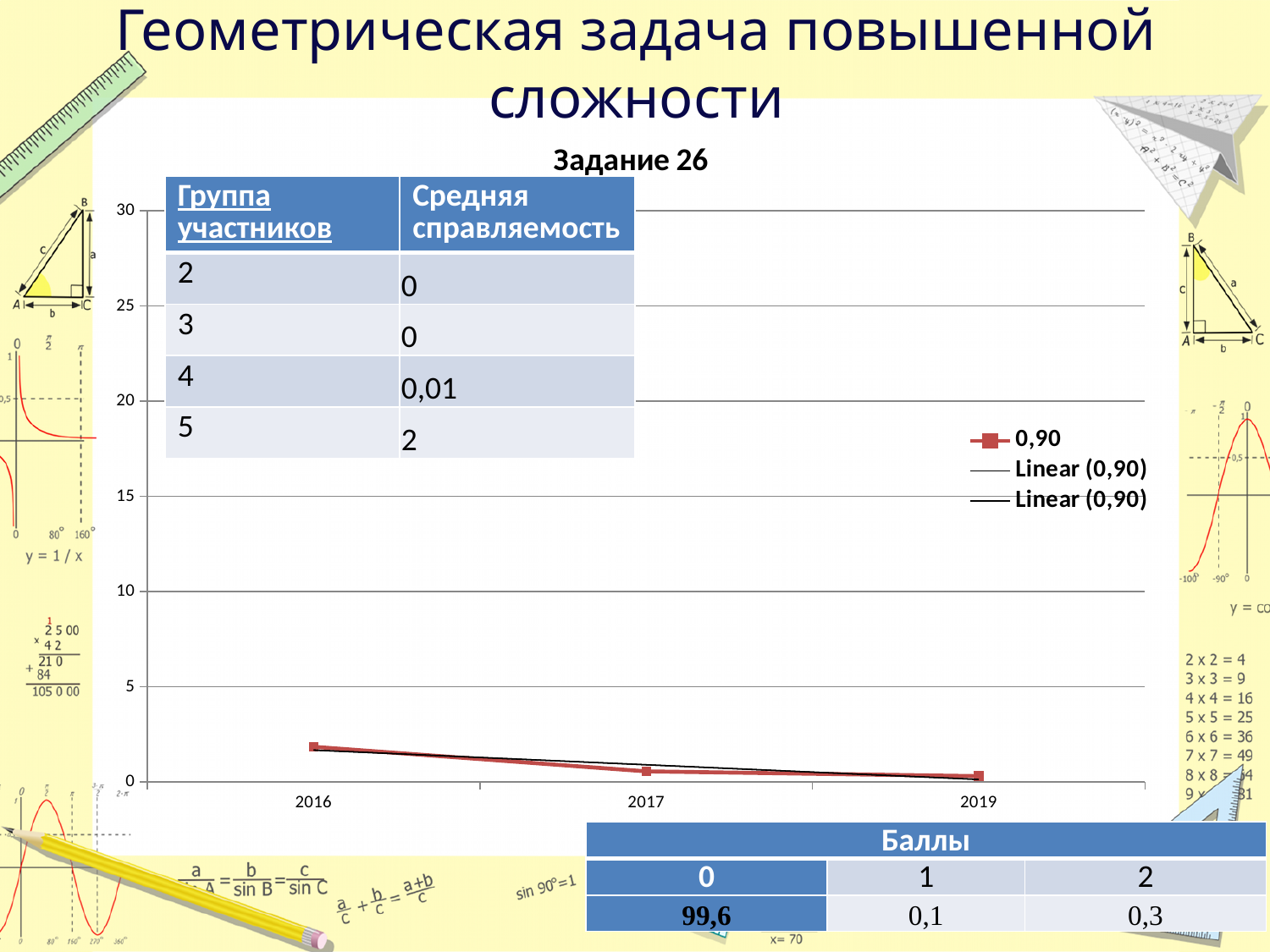
Which is larger, the value for 2016 or the value for 2017? 2016 Is the value for 2016 greater or less than 5? less Do the values rise or fall from 2016 to 2019? fall Which year has the highest value on the chart? 2016 How many years are shown along the x axis of the chart? 3 How many entries does the chart legend list? 3 What kind of chart is shown on the slide? line chart Is the value for 2017 greater or less than 5? less What is the title of the chart? Задание 26 Is the value for 2019 greater or less than 10? less What is the name of the data series shown with red square markers in the legend? 0,90 What is the highest value marked on the y axis of the chart? 30